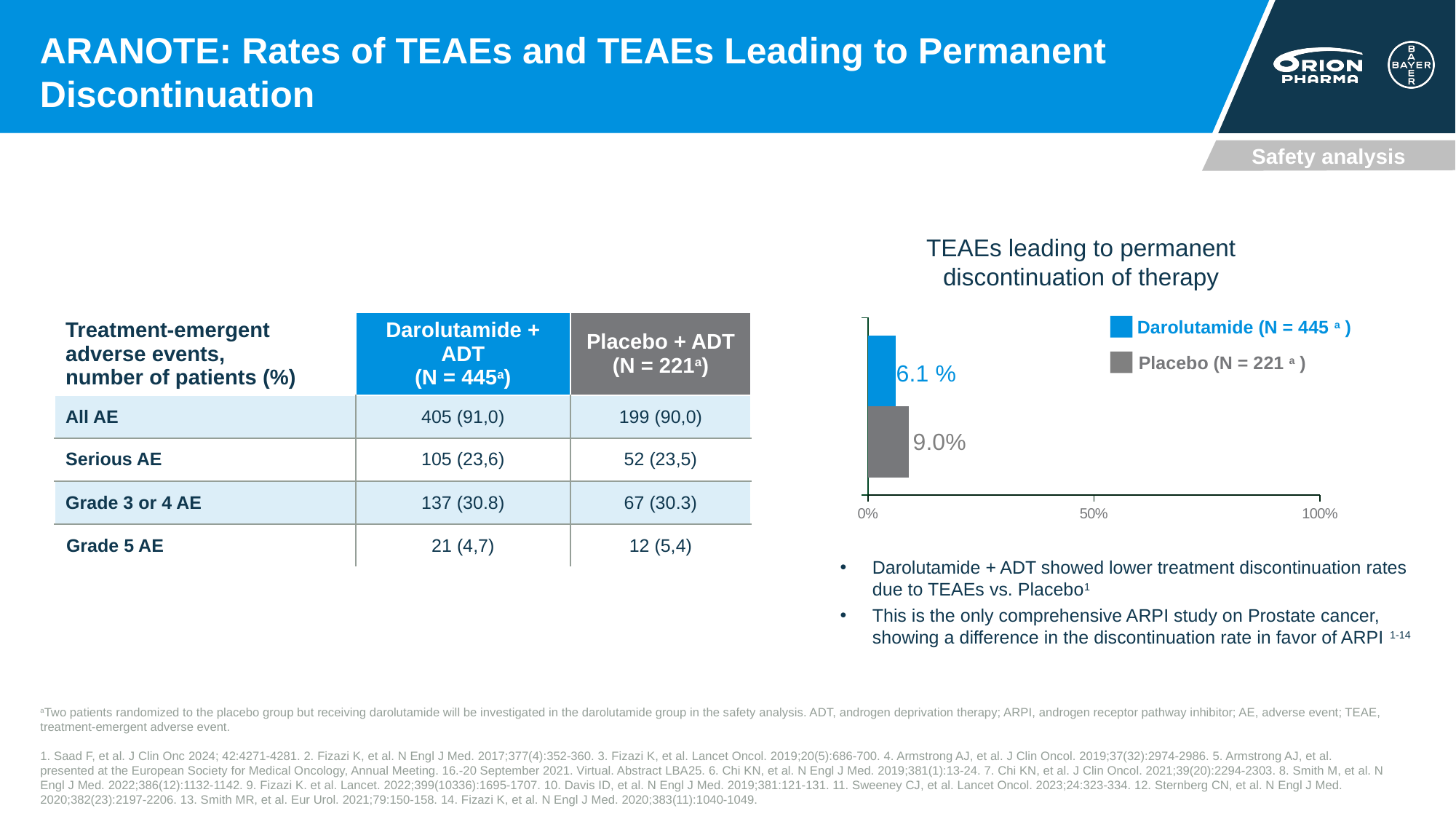
How many bars are plotted in the chart 'TEAEs leading to permanent discontinuation of therapy'? 2 In the chart 'TEAEs leading to permanent discontinuation of therapy', is the value for Placebo greater or less than 50%? less What is the title of the chart on the right side of the slide? TEAEs leading to permanent discontinuation of therapy In the chart 'TEAEs leading to permanent discontinuation of therapy', what colour is the Darolutamide bar? Blue In the chart 'TEAEs leading to permanent discontinuation of therapy', which group has the lower discontinuation rate? Darolutamide In the chart 'TEAEs leading to permanent discontinuation of therapy', is the value for Darolutamide or for Placebo larger? Placebo How many series does the legend of the chart 'TEAEs leading to permanent discontinuation of therapy' list? 2 What kind of chart is 'TEAEs leading to permanent discontinuation of therapy'? Bar chart In the chart 'TEAEs leading to permanent discontinuation of therapy', what is the value shown for Darolutamide (N = 445)? 6.1 % In the chart 'TEAEs leading to permanent discontinuation of therapy', what is the value shown for Placebo (N = 221)? 9.0% In the chart 'TEAEs leading to permanent discontinuation of therapy', what is the difference between the Placebo value and the Darolutamide value? 2.9% In the chart 'TEAEs leading to permanent discontinuation of therapy', which group has the higher discontinuation rate? Placebo